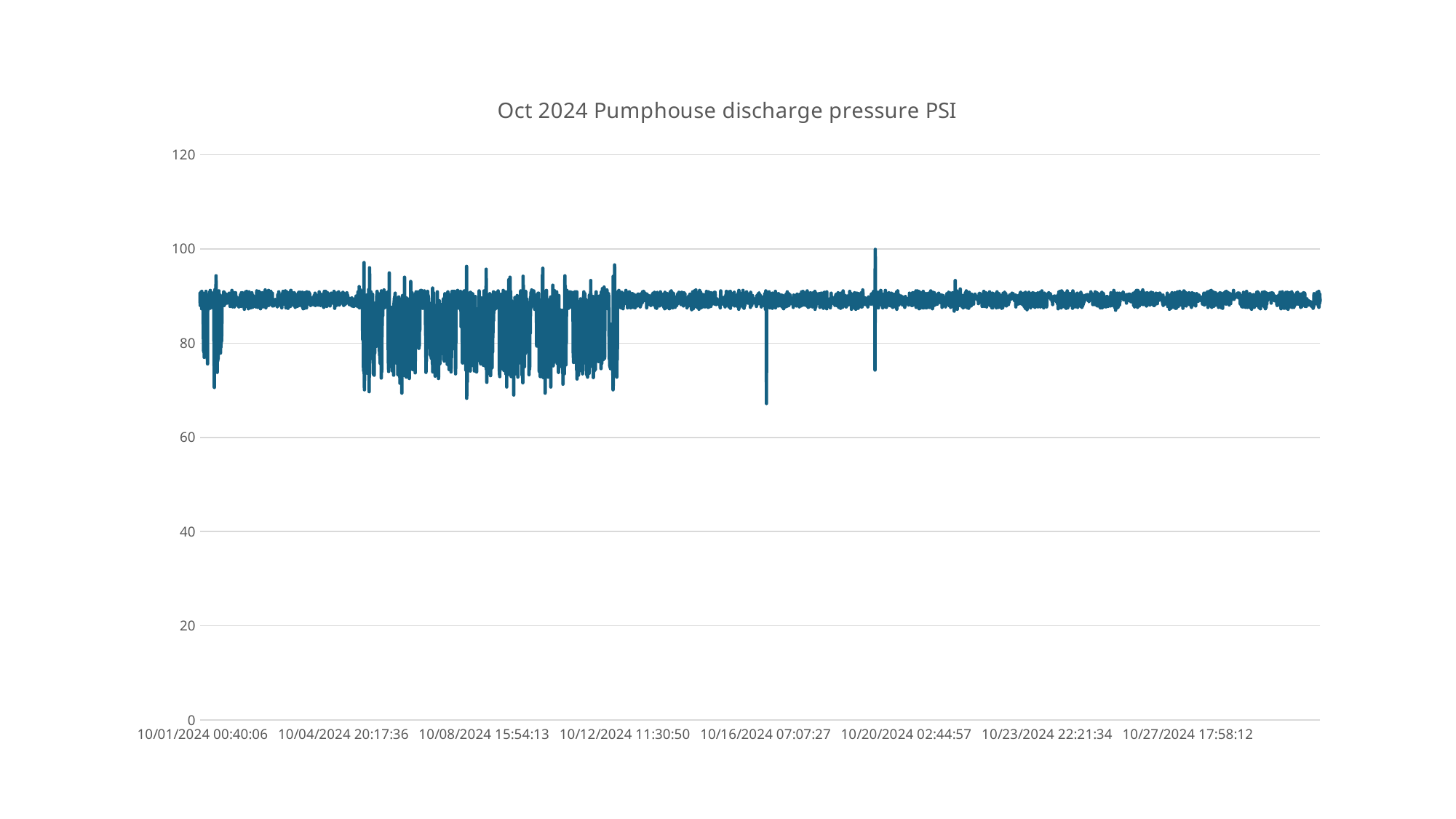
Is the lowest dip in the pressure line greater or less than 40? greater How many date labels are shown along the x axis? 8 What is the first date label on the x axis? 10/01/2024 00:40:06 What is the title of the chart? Oct 2024 Pumphouse discharge pressure PSI Is the lowest dip in the pressure line greater or less than 60? greater Is the pressure value around 10/27/2024 17:58:12 greater or less than 60? greater What kind of chart is shown on the slide? line chart